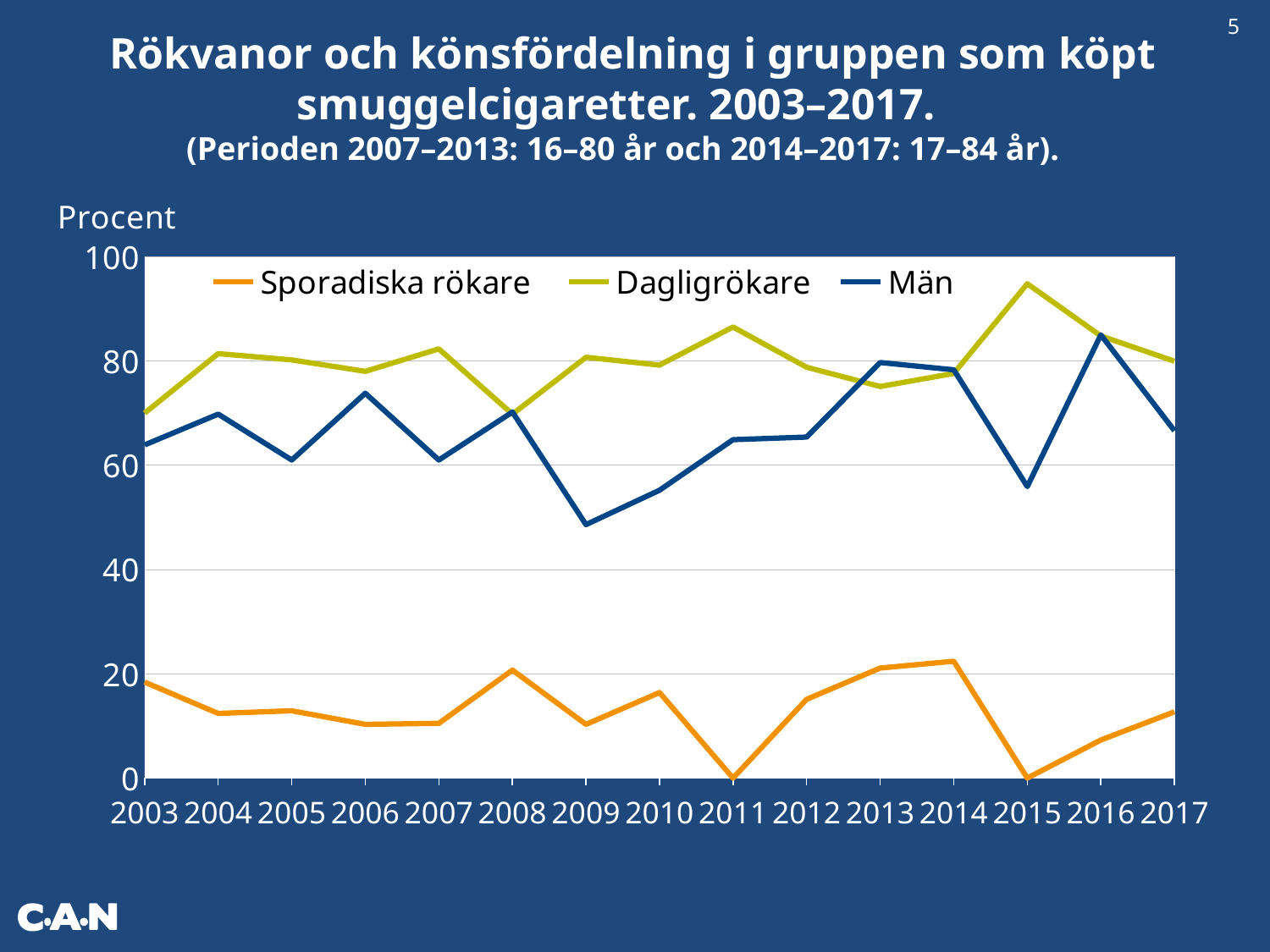
What is the value for Sporadiska rökare in 2015? 0 Does the value for Män rise or fall from 2006 to 2009? fall In which year is the value for Män lowest? 2009 What kind of chart is shown on the slide? line chart Which is larger in 2013, the value for Män or the value for Dagligrökare? Män How many years are plotted along the x axis? 15 What is the value for Sporadiska rökare in 2011? 0 In which year is the value for Dagligrökare highest? 2015 Is the value for Dagligrökare in 2015 greater or less than 80? greater Is the value for Män in 2009 greater or less than 60? less How many series does the legend list? 3 What label is shown on the vertical axis? Procent